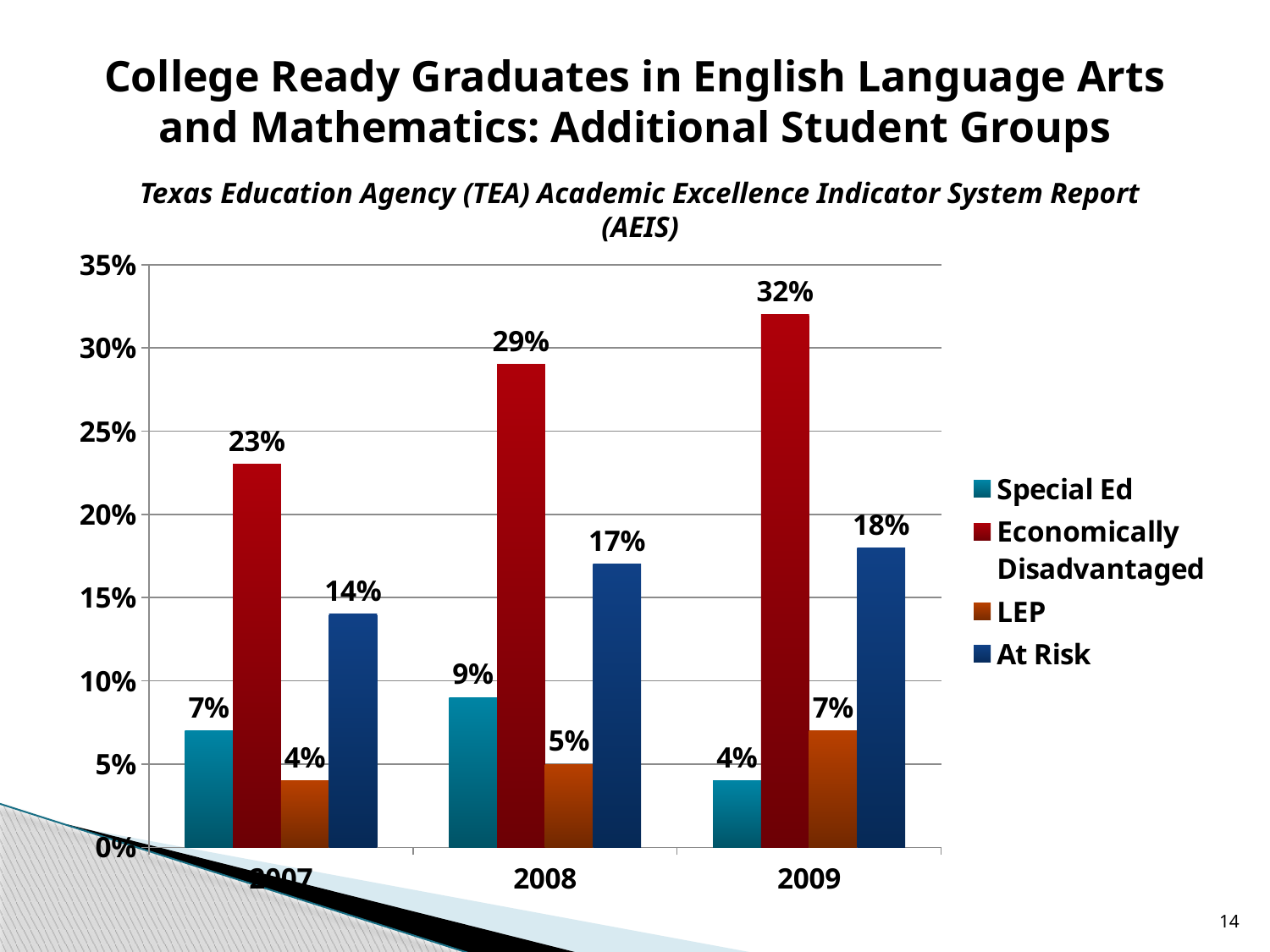
What is the value for LEP in 2007? 4% Do the Economically Disadvantaged values rise or fall from 2007 to 2009? Rise Which series has the highest value in 2009? Economically Disadvantaged How many years are shown on the x axis? 3 How many series does the legend list? 4 What kind of chart is shown on the slide? Bar chart What is the value for Special Ed in 2008? 9% What is the value for Economically Disadvantaged in 2009? 32% What is the value for At Risk in 2008? 17% Which is larger, the At Risk value in 2009 or the At Risk value in 2007? At Risk in 2009 What is the difference between the Economically Disadvantaged values in 2009 and 2007? 9% Which series has the lowest value in 2007? LEP